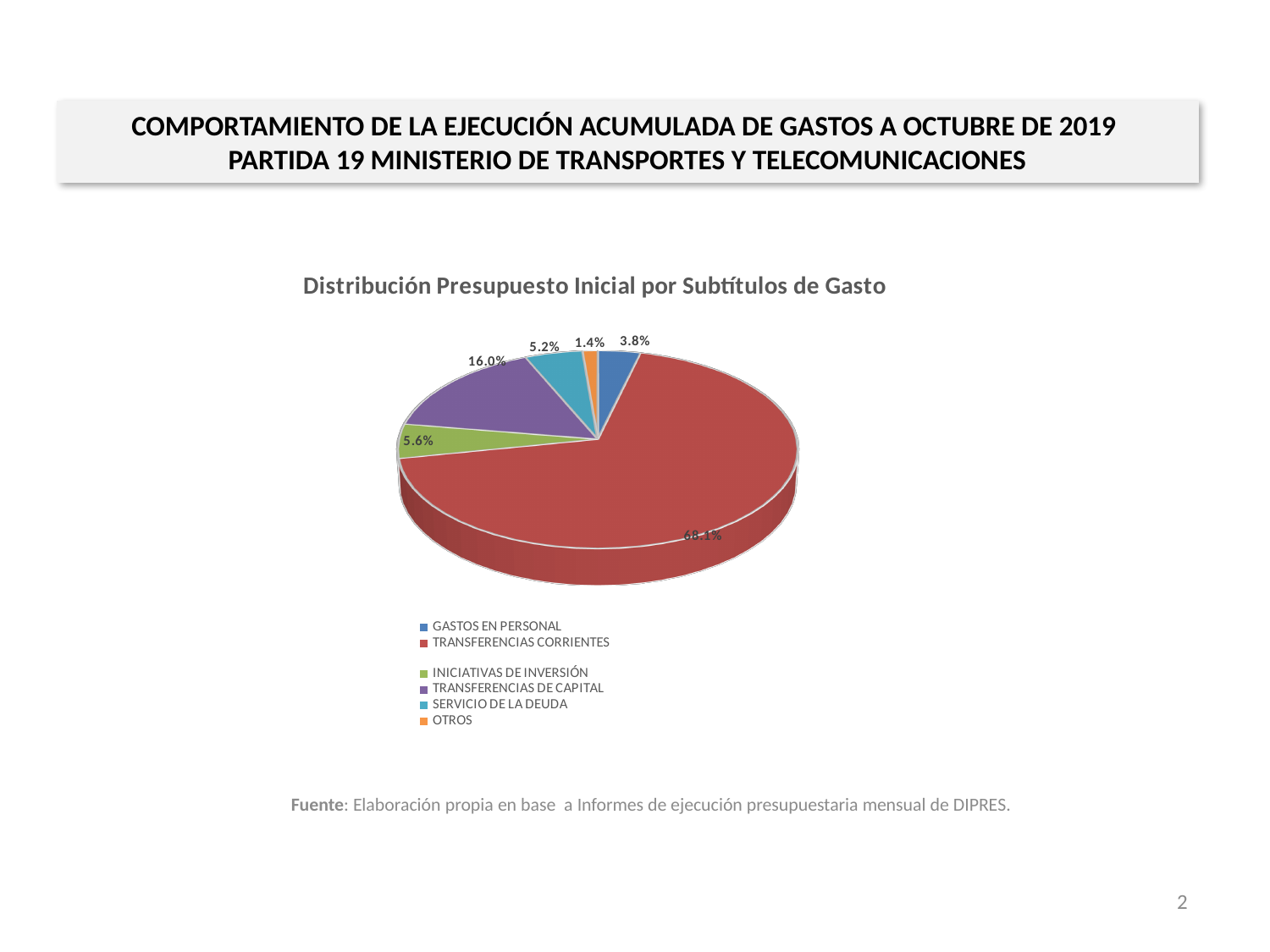
What share of the pie does TRANSFERENCIAS DE CAPITAL represent? 16.0% What share of the pie does TRANSFERENCIAS CORRIENTES represent? 68.1% What is the value shown for SERVICIO DE LA DEUDA? 5.2% What is the value shown for OTROS? 1.4% Which category has the smallest slice of the pie? OTROS How many categories does the legend of the pie chart list? 6 What is the title of the chart? Distribución Presupuesto Inicial por Subtítulos de Gasto What is the difference between the shares of TRANSFERENCIAS DE CAPITAL and INICIATIVAS DE INVERSIÓN? 10.4% What is the value shown for GASTOS EN PERSONAL? 3.8% Which category has the largest slice of the pie? TRANSFERENCIAS CORRIENTES What kind of chart is shown on the slide? Pie chart Which is larger, the share for INICIATIVAS DE INVERSIÓN or the share for GASTOS EN PERSONAL? INICIATIVAS DE INVERSIÓN